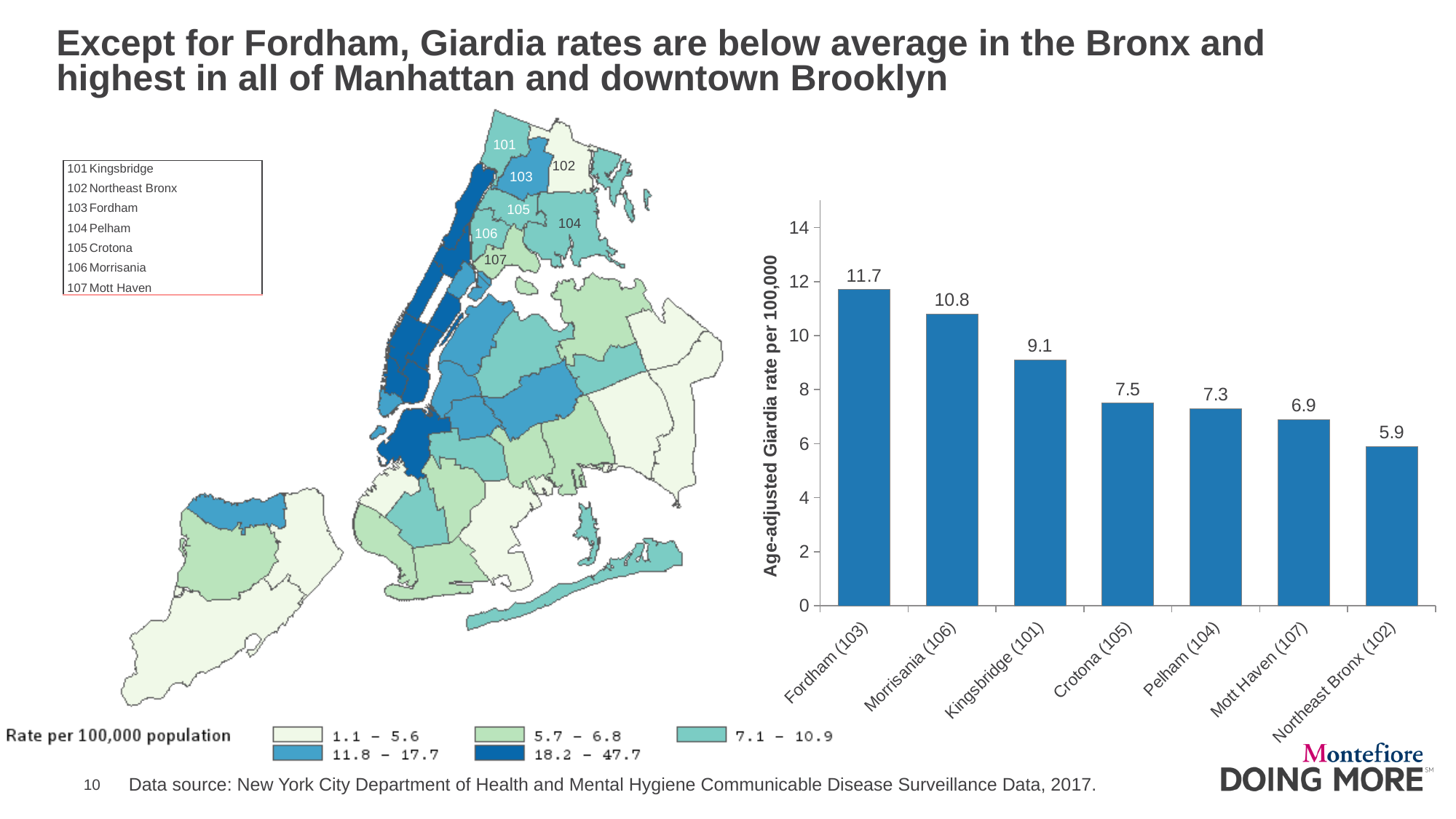
What is the difference between the Giardia rates for Kingsbridge (101) and Mott Haven (107)? 2.2 How many neighborhoods are shown in the bar chart? 7 What kind of chart is used to show the Giardia rates by neighborhood? Bar chart Which neighborhood has the highest age-adjusted Giardia rate in the bar chart? Fordham (103) What is the difference between the Giardia rates for Fordham (103) and Morrisania (106)? 0.9 What is the age-adjusted Giardia rate per 100,000 for Fordham (103)? 11.7 What is the age-adjusted Giardia rate per 100,000 for Crotona (105)? 7.5 Which neighborhood has the lowest age-adjusted Giardia rate in the bar chart? Northeast Bronx (102) What is the age-adjusted Giardia rate per 100,000 for Northeast Bronx (102)? 5.9 Do the Giardia rates rise or fall from left to right across the bar chart? Fall Which has a higher Giardia rate, Pelham (104) or Mott Haven (107)? Pelham (104) Is the Giardia rate for Kingsbridge (101) greater or less than 8? greater